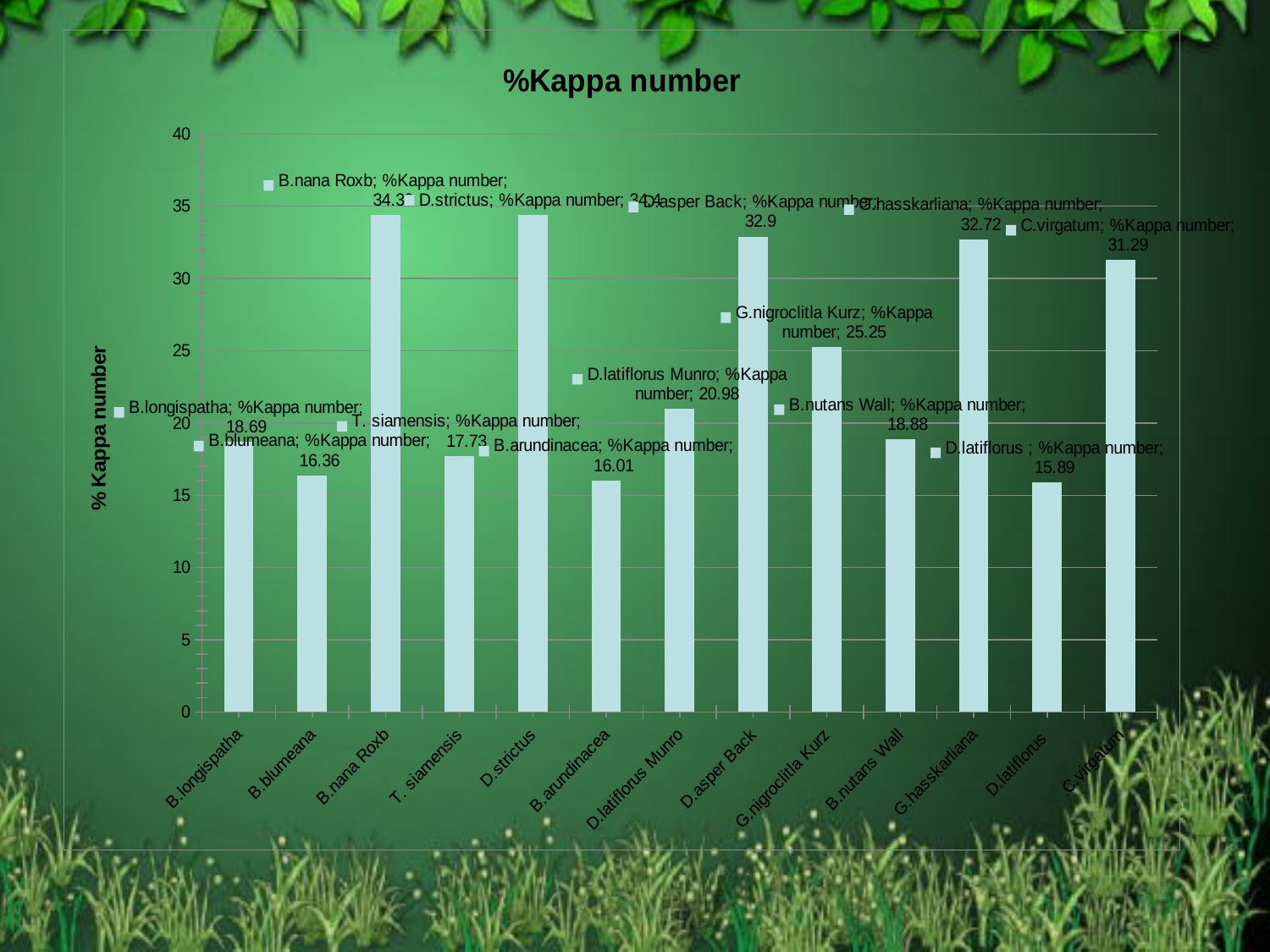
Is the value for B.nana Roxb greater or less than 30? greater What is the %Kappa number for G.nigroclitla Kurz? 25.25 Which has a higher %Kappa number, D.asper Back or C.virgatum? D.asper Back Is the value for T. siamensis greater or less than 20? less What is the %Kappa number for B.longispatha? 18.69 What is the title of the chart? %Kappa number What is the %Kappa number for C.virgatum? 31.29 What is the %Kappa number for D.asper Back? 32.9 How many bamboo species (categories) are shown on the x axis? 13 What is the difference between the %Kappa number of G.nigroclitla Kurz and B.nutans Wall? 6.37 What kind of chart is shown on the slide? Bar chart What is the %Kappa number for B.arundinacea? 16.01